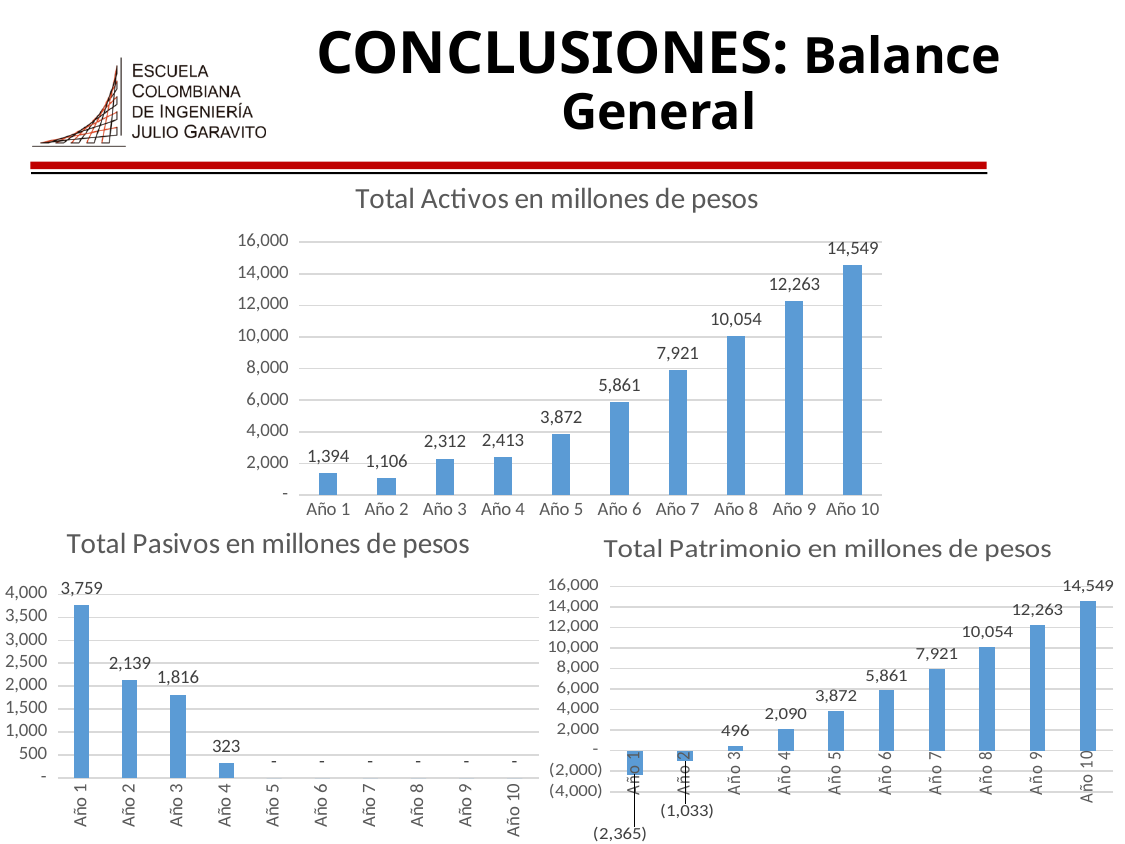
In the 'Total Activos en millones de pesos' chart, which year has the lowest value? Año 2 In the 'Total Pasivos en millones de pesos' chart, what is the value for Año 4? 323 In the 'Total Activos en millones de pesos' chart, what is the difference between Año 9 and Año 8? 2,209 What type of chart is 'Total Patrimonio en millones de pesos'? bar chart In the 'Total Activos en millones de pesos' chart, what is the value for Año 10? 14,549 In the 'Total Pasivos en millones de pesos' chart, which year has the highest value? Año 1 In the 'Total Patrimonio en millones de pesos' chart, which is larger, Año 4 or Año 5? Año 5 In the 'Total Activos en millones de pesos' chart, how many years are shown on the x axis? 10 In the 'Total Pasivos en millones de pesos' chart, what is the value for Año 1? 3,759 In the 'Total Patrimonio en millones de pesos' chart, what is the value for Año 1? (2,365) In the 'Total Pasivos en millones de pesos' chart, do the values rise or fall from Año 1 to Año 4? fall In the 'Total Patrimonio en millones de pesos' chart, what is the value for Año 3? 496